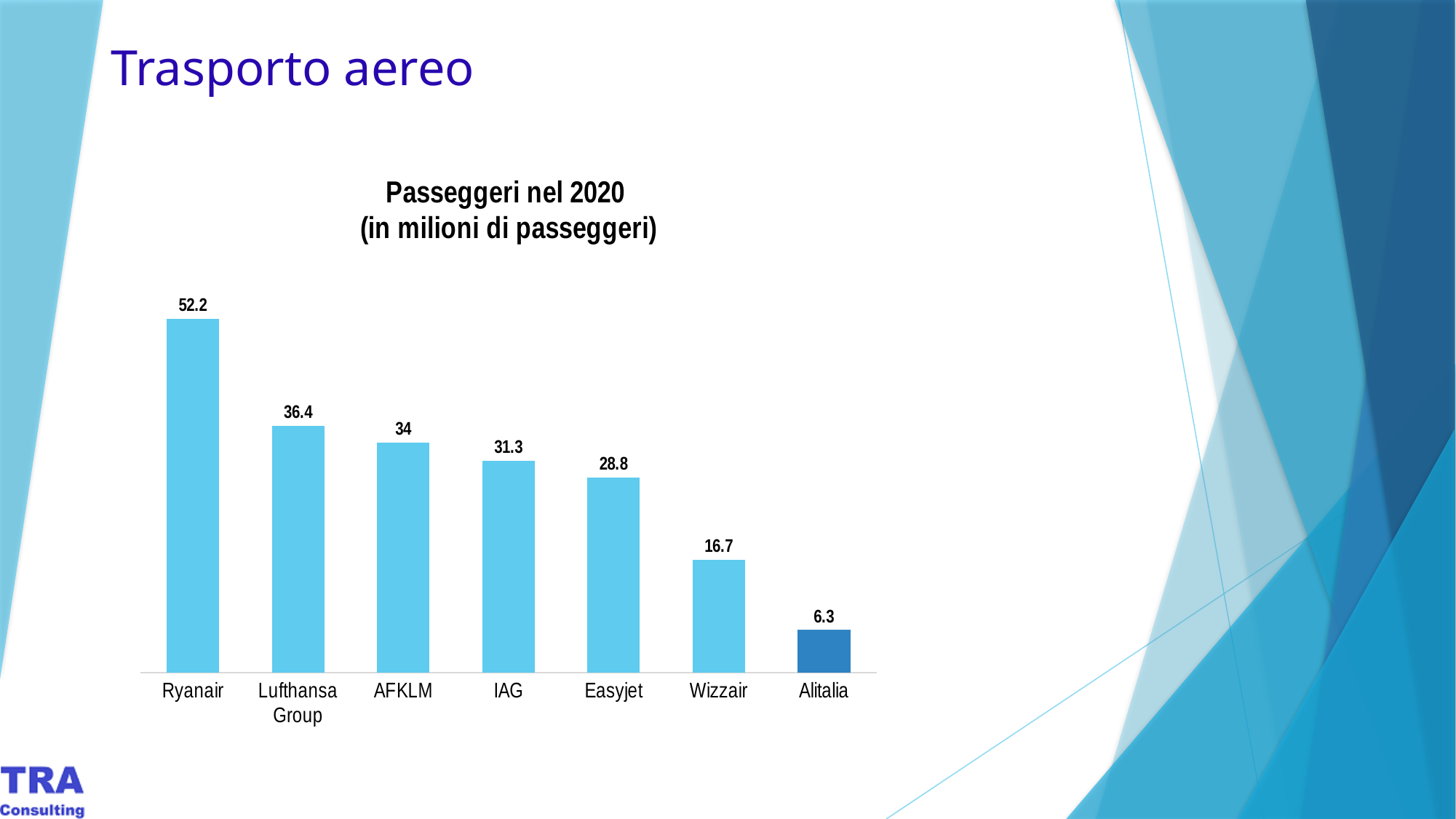
What is the value for Alitalia? 6.3 Which is larger, the value for Easyjet or the value for Wizzair? Easyjet Which airline has the lowest number of passengers? Alitalia What is the title of the chart? Passeggeri nel 2020 (in milioni di passeggeri) What is the value for Wizzair? 16.7 What is the value for Ryanair? 52.2 How many airlines are shown in the chart? 7 What is the value for Lufthansa Group? 36.4 What kind of chart is shown on the slide? Bar chart What is the difference between the values for Ryanair and Lufthansa Group? 15.8 Which airline has the highest number of passengers? Ryanair What is the difference between the values for AFKLM and IAG? 2.7